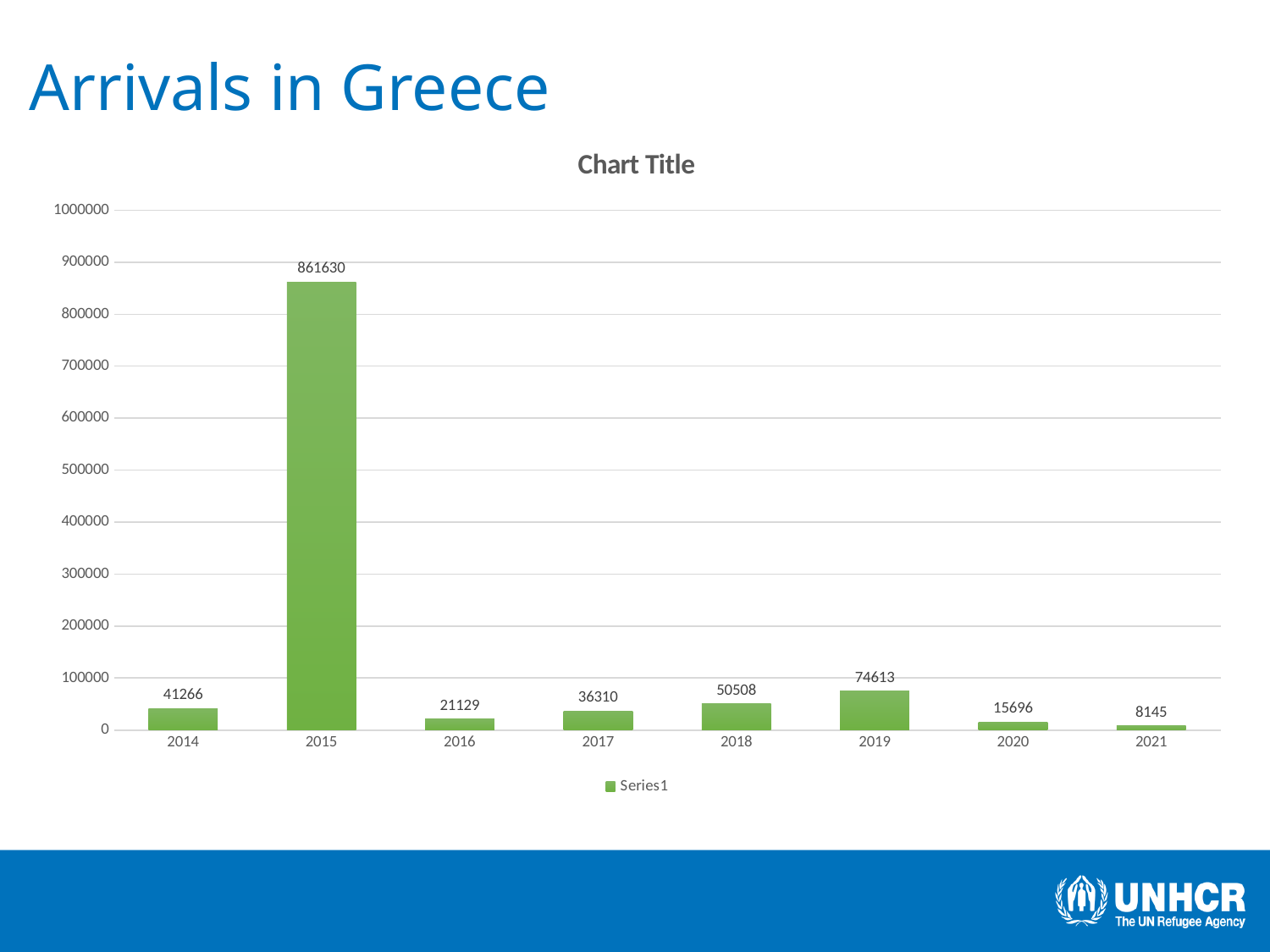
Do the values rise or fall from 2019 to 2021? fall How many years are shown on the x axis? 8 What is the difference between the values for 2018 and 2017? 14198 Which year has the lowest value? 2021 Which year has the highest value? 2015 Is the value for 2019 greater or less than 100000? less How many series does the legend list? 1 What is the value for 2019? 74613 What is the value for 2015? 861630 What is the value for 2021? 8145 What kind of chart is shown? bar chart Which is larger, the value for 2014 or the value for 2016? 2014